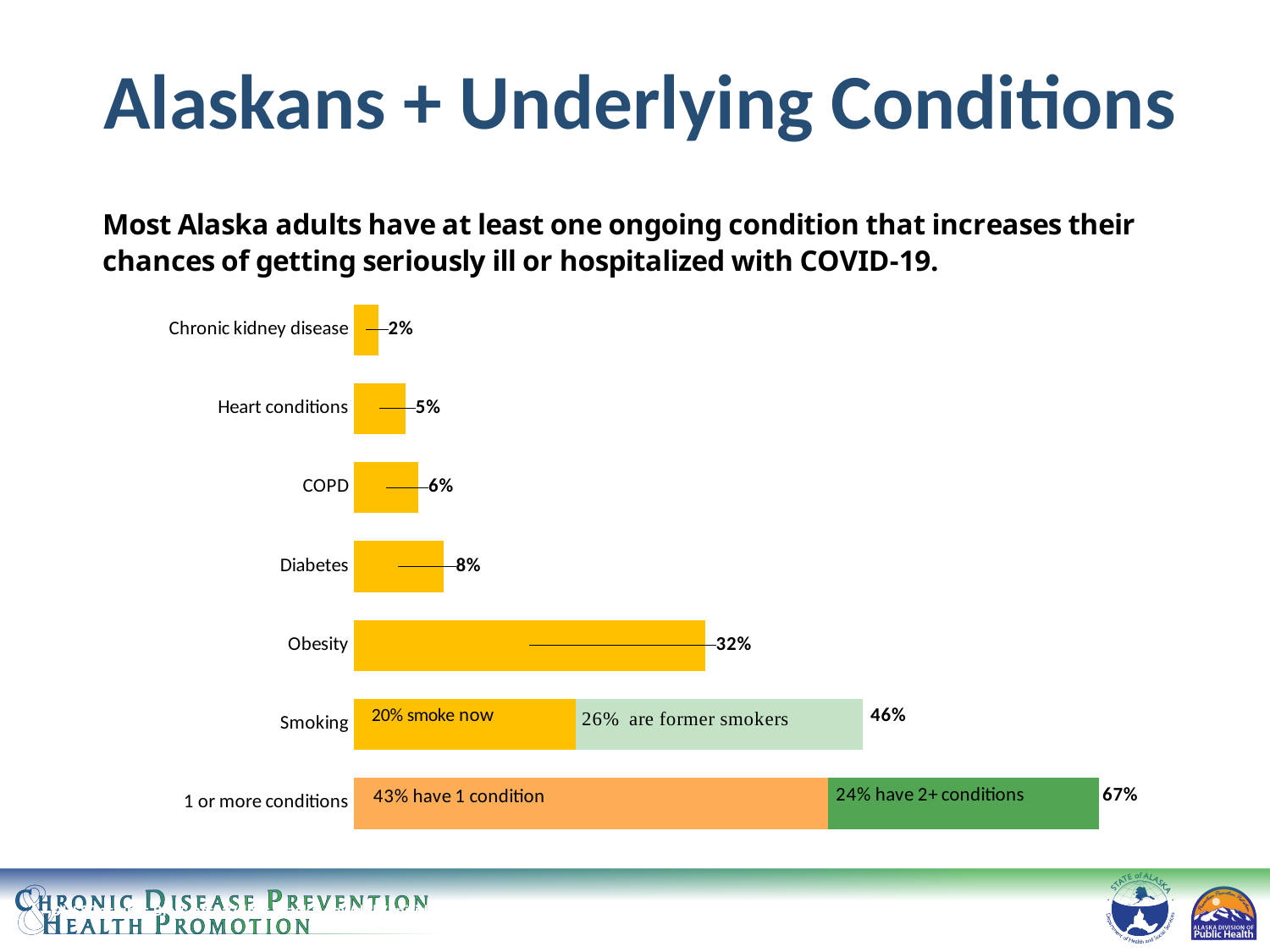
How many categories are shown on the chart? 7 What percentage is shown for Chronic kidney disease? 2% What is the difference between the values for Obesity and Diabetes? 24% What percentage of Alaska adults have diabetes according to the chart? 8% Which category has the lowest value on the chart? Chronic kidney disease What is the total value shown for the '1 or more conditions' bar? 67% What is the total value shown for the Smoking bar? 46% What kind of chart is shown on the slide? Bar chart Which category has the highest value on the chart? 1 or more conditions Which is larger, the value for COPD or the value for Heart conditions? COPD What percentage of Alaska adults have 2+ conditions according to the chart? 24% What is the value shown for Obesity? 32%